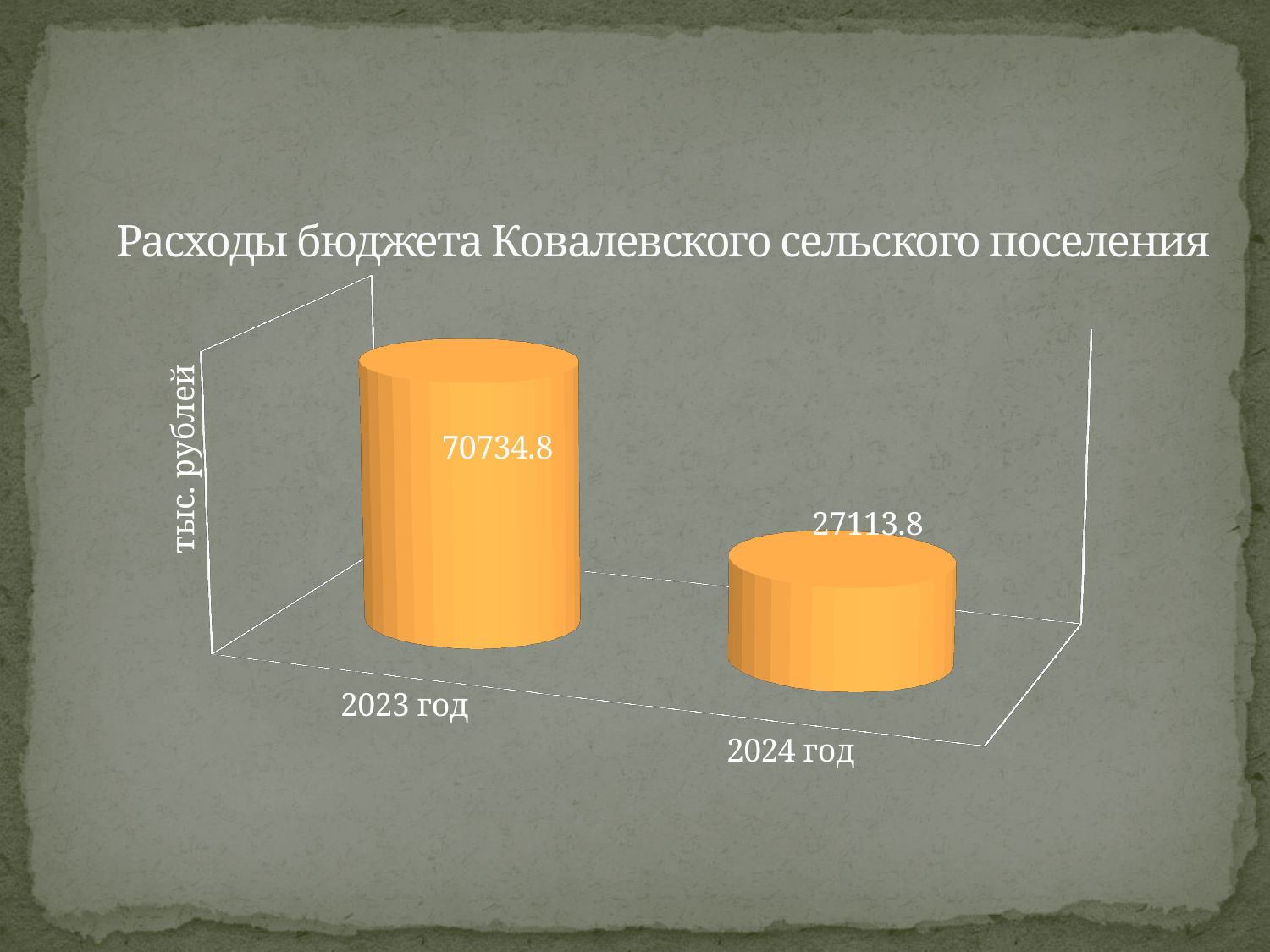
Which year has the highest value on the chart? 2023 год What is the budget expenditure value shown for 2023 год? 70734.8 Do the values rise or fall from 2023 год to 2024 год? Fall What is the budget expenditure value shown for 2024 год? 27113.8 Which is larger, the value for 2023 год or the value for 2024 год? 2023 год What is the title of the chart? Расходы бюджета Ковалевского сельского поселения By how much does the value for 2023 год exceed the value for 2024 год? 43621 Which year has the lowest value on the chart? 2024 год How many categories (years) are plotted on the chart? 2 What kind of chart is shown on the slide? Bar chart What unit is given on the vertical axis label of the chart? тыс. рублей